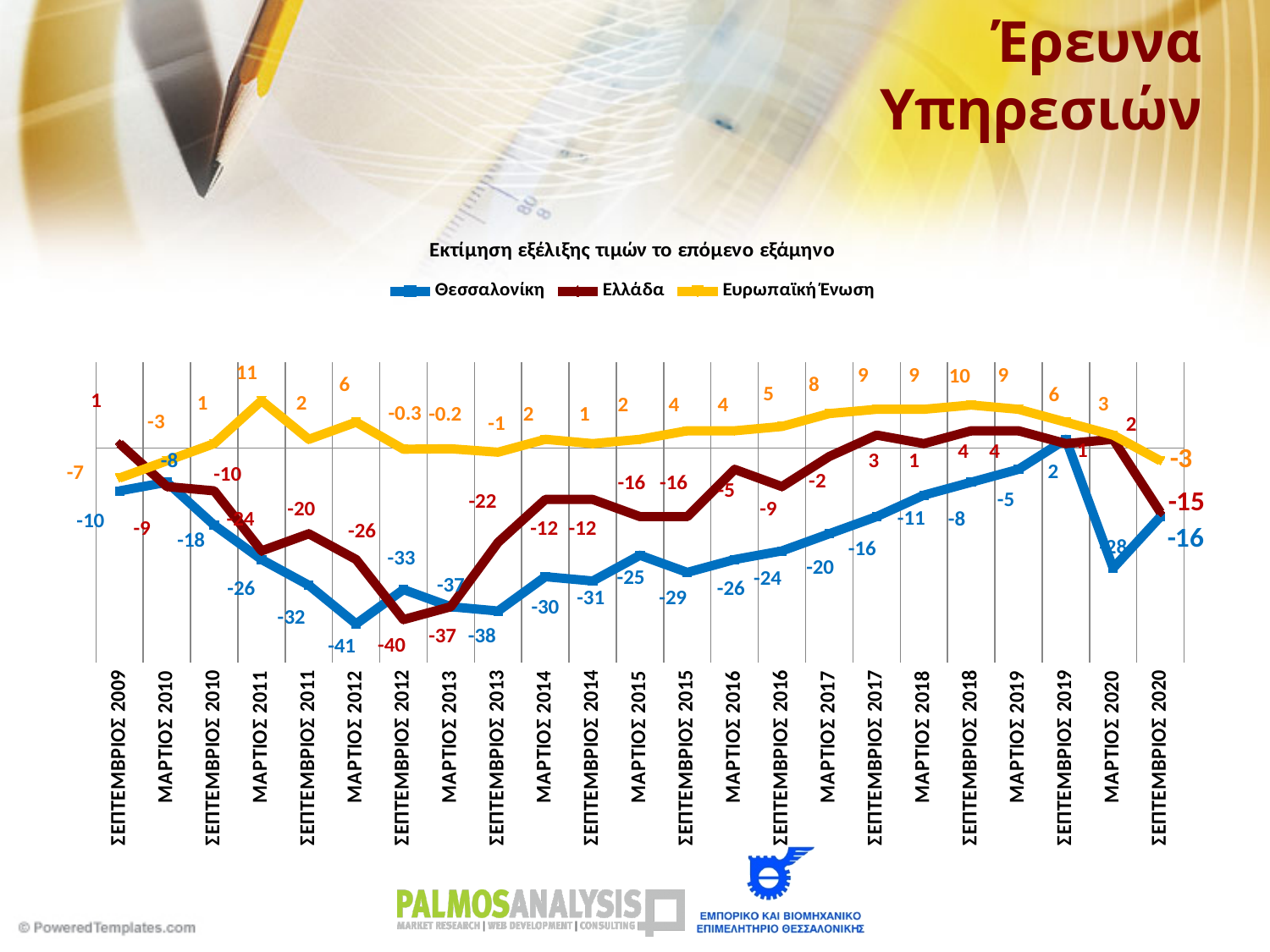
How many time points are plotted along the x axis? 23 What is the title of the chart? Εκτίμηση εξέλιξης τιμών το επόμενο εξάμηνο What is the value for Ελλάδα in Σεπτέμβριος 2020? -15 In which period does Ελλάδα reach its lowest value? Σεπτέμβριος 2012 What is the value for Θεσσαλονίκη in Μάρτιος 2012? -41 By how much did the Θεσσαλονίκη value fall from Σεπτέμβριος 2019 to Μάρτιος 2020? 30 In which period does Ευρωπαϊκή Ένωση reach its highest value? Μάρτιος 2011 What kind of chart is shown on the slide? line chart What is the value for Ευρωπαϊκή Ένωση in Μάρτιος 2011? 11 In which period does Θεσσαλονίκη reach its lowest value? Μάρτιος 2012 What is the value for Θεσσαλονίκη in Σεπτέμβριος 2019? 2 How many series does the legend list? 3